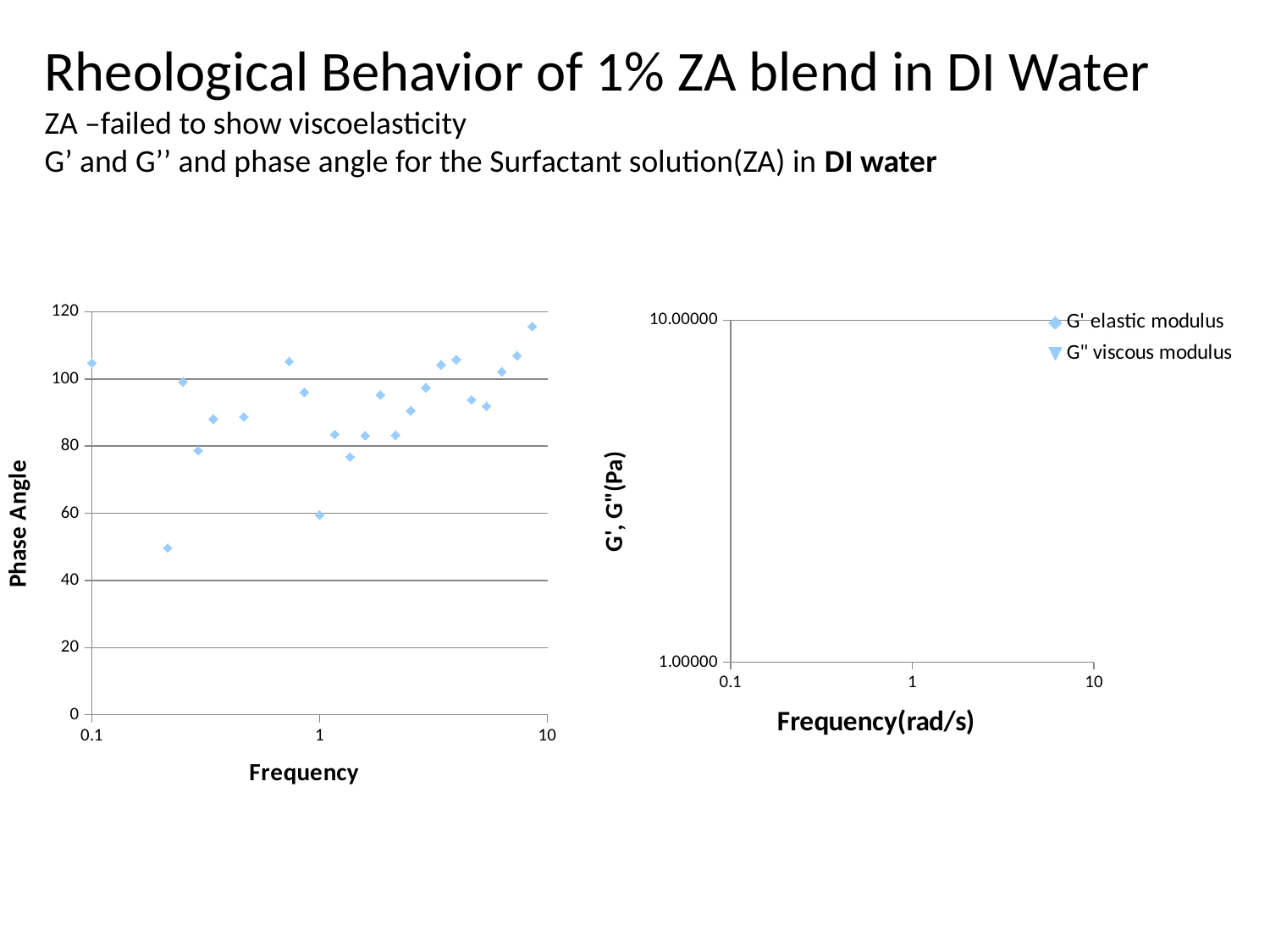
On the right chart, what is the highest value shown on the y axis? 10.00000 On the left chart, is the lowest plotted phase angle greater or less than 60? less On the left chart, is the phase angle at frequency 1 greater or less than 80? less On the left chart, is the highest plotted phase angle greater or less than 100? greater On the left chart, what is the x-axis title? Frequency What kind of chart is the left chart (Phase Angle vs Frequency)? scatter chart On the left chart, is the phase angle at frequency 1 larger or smaller than the phase angle at frequency 0.1? smaller On the right chart, what is the x-axis title? Frequency(rad/s) On the right chart, how many series does the legend list? 2